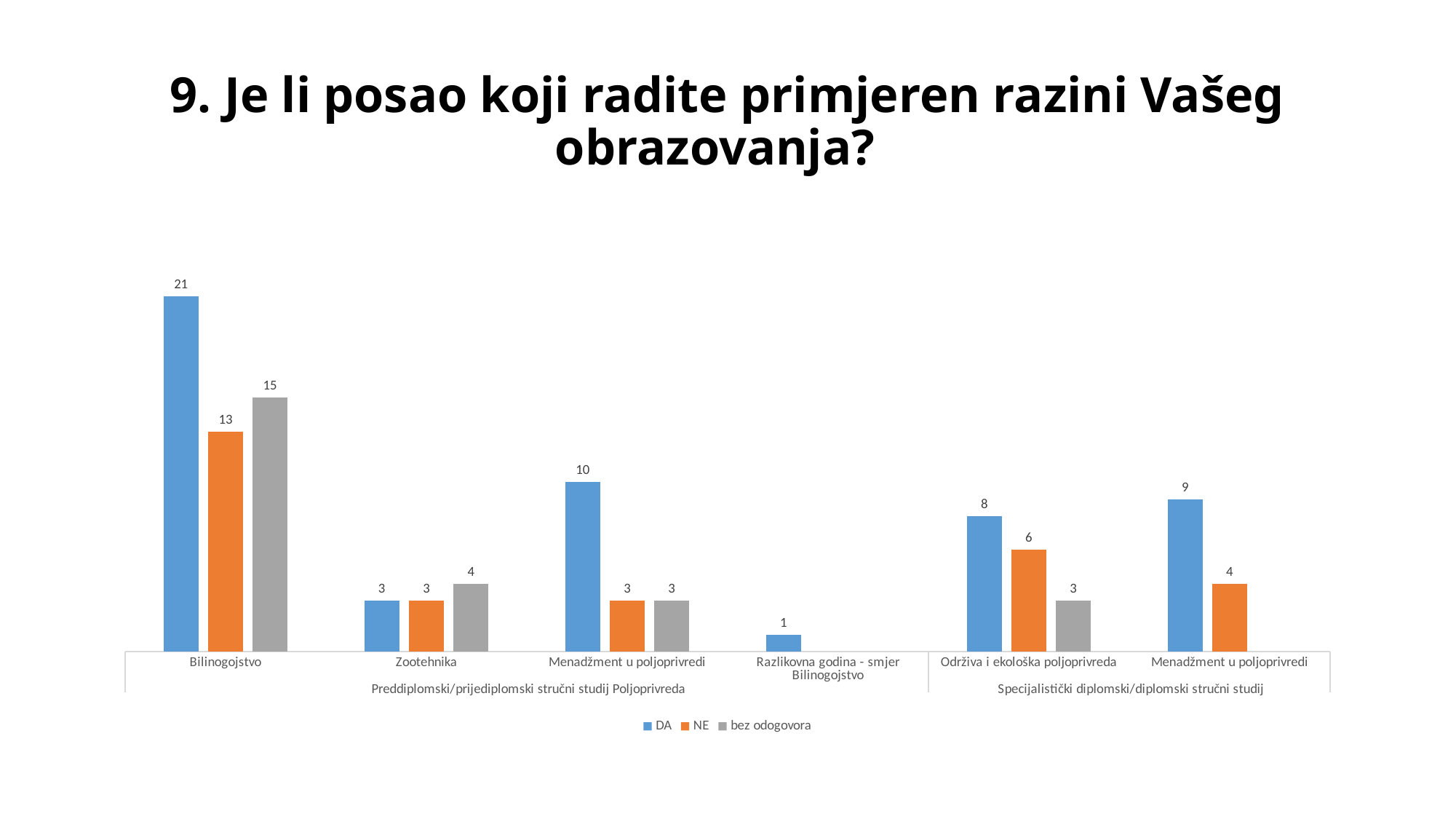
What is the 'bez odogovora' value for Zootehnika? 4 Which category has the lowest DA value? Razlikovna godina - smjer Bilinogojstvo What colour are the DA bars? blue What kind of chart is shown on the slide? bar chart How many categories are shown on the x axis? 6 Which category has the highest DA value? Bilinogojstvo Which is larger for Bilinogojstvo: the NE value or the 'bez odogovora' value? bez odogovora How many series does the legend list? 3 What is the DA value for Menadžment u poljoprivredi in the Specijalistički diplomski/diplomski stručni studij group? 9 What is the NE value for Održiva i ekološka poljoprivreda? 6 What is the difference between the DA and NE values for Bilinogojstvo? 8 What is the DA value for Bilinogojstvo? 21